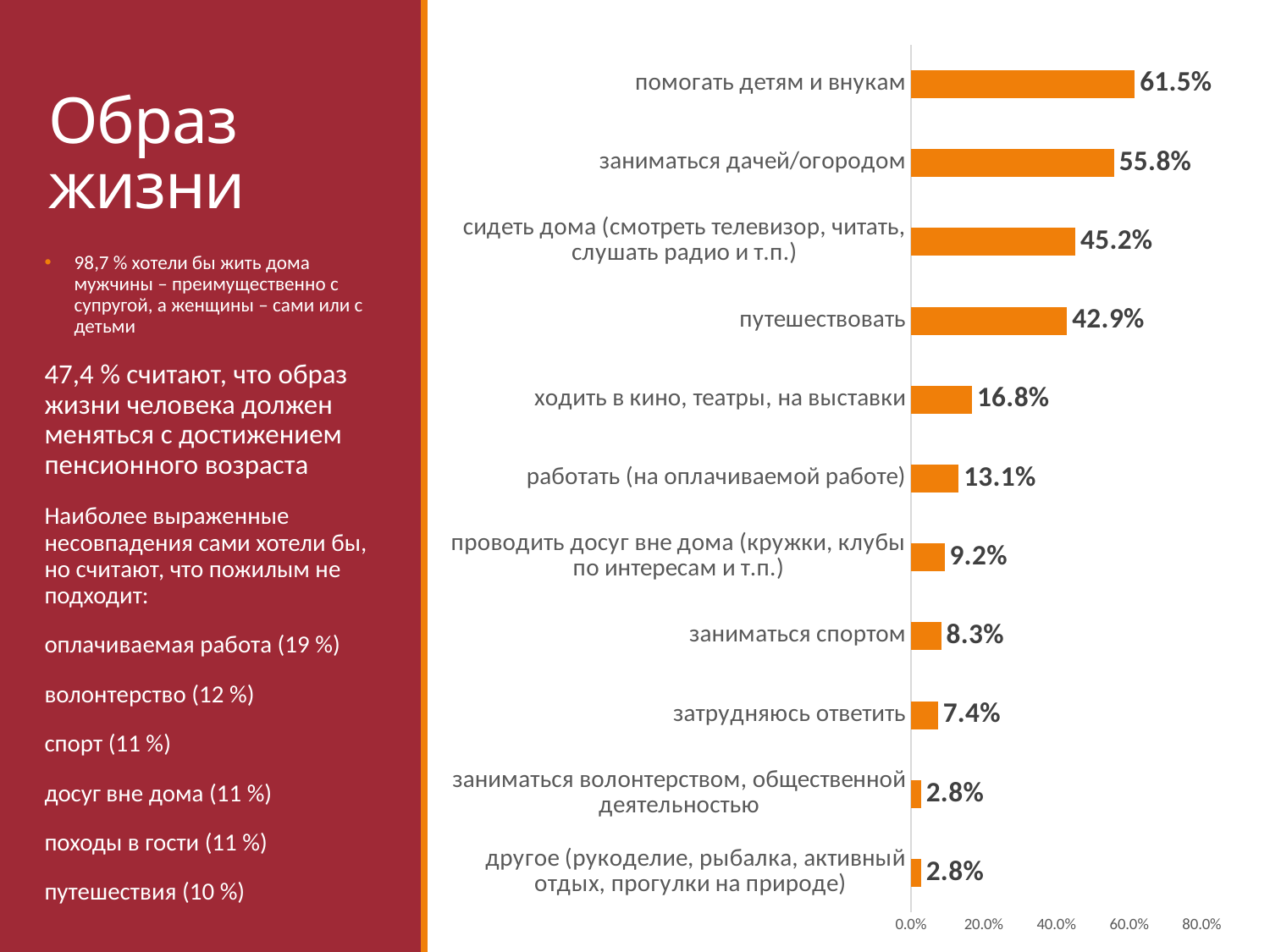
What is the value for "помогать детям и внукам"? 61.5% What is the value for "затрудняюсь ответить"? 7.4% What is the difference between "ходить в кино, театры, на выставки" and "работать (на оплачиваемой работе)"? 3.7% How many categories are shown in the chart? 11 What is the difference between "помогать детям и внукам" and "заниматься дачей/огородом"? 5.7% Which is larger: "сидеть дома (смотреть телевизор, читать, слушать радио и т.п.)" or "путешествовать"? сидеть дома (смотреть телевизор, читать, слушать радио и т.п.) What kind of chart is shown on the slide? bar chart What is the value for "заниматься спортом"? 8.3% Which category has the highest value? помогать детям и внукам What is the value for "путешествовать"? 42.9% Is the value for "заниматься дачей/огородом" greater or less than 40.0%? greater What is the highest tick value shown on the horizontal axis? 80.0%